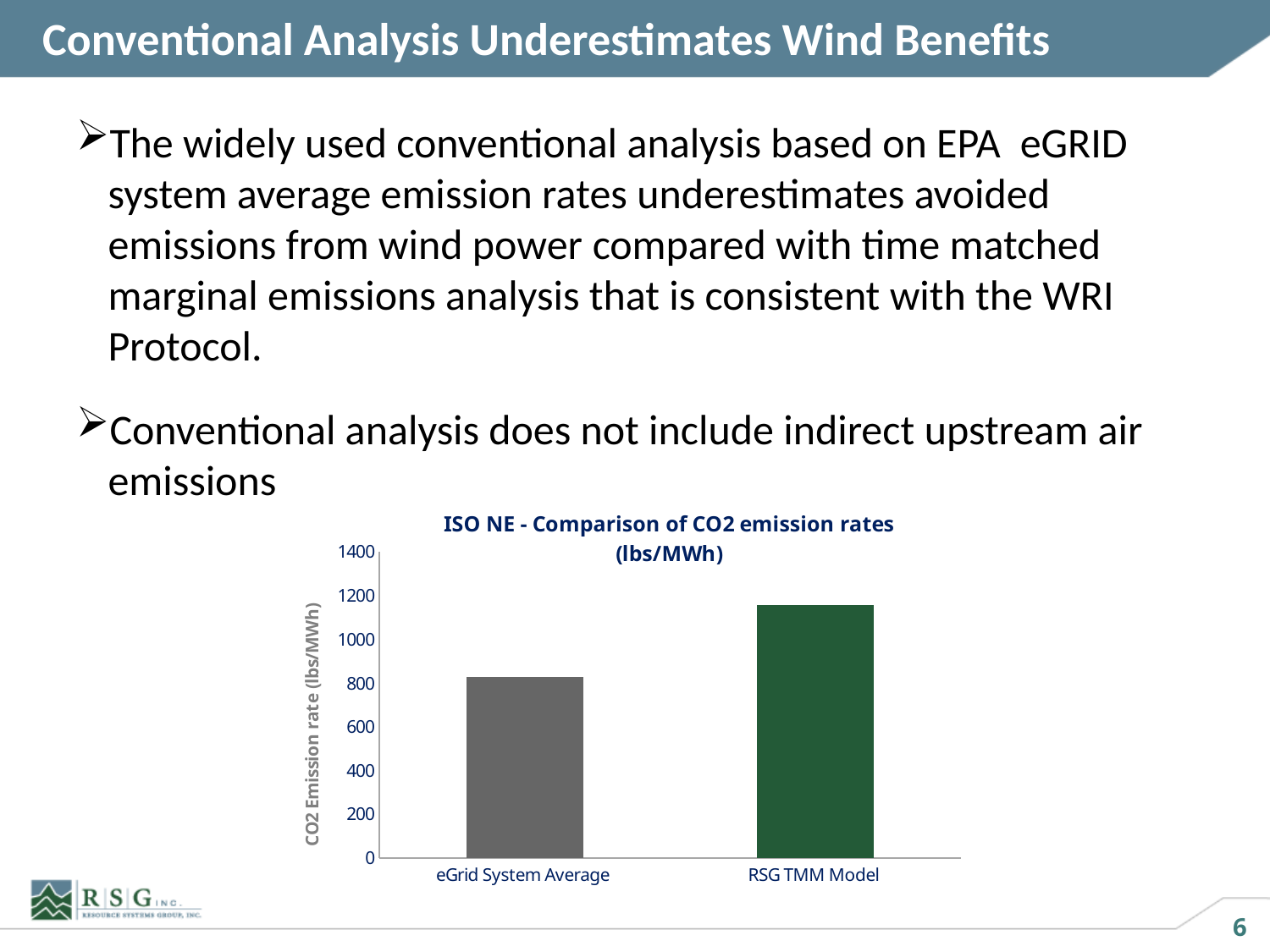
Is the value for eGrid System Average greater or less than 600? greater What is the title of the chart? ISO NE - Comparison of CO2 emission rates (lbs/MWh) Which is larger, the value for eGrid System Average or the value for RSG TMM Model? RSG TMM Model What is the label of the vertical axis? CO2 Emission rate (lbs/MWh) Is the value for RSG TMM Model greater or less than 1200? less Which category has the highest CO2 emission rate? RSG TMM Model How many categories are plotted in the chart? 2 What type of chart is shown on the slide? bar chart Do the values rise or fall from left to right across the categories? rise Is the value for RSG TMM Model greater or less than 1000? greater Which category has the lowest CO2 emission rate? eGrid System Average